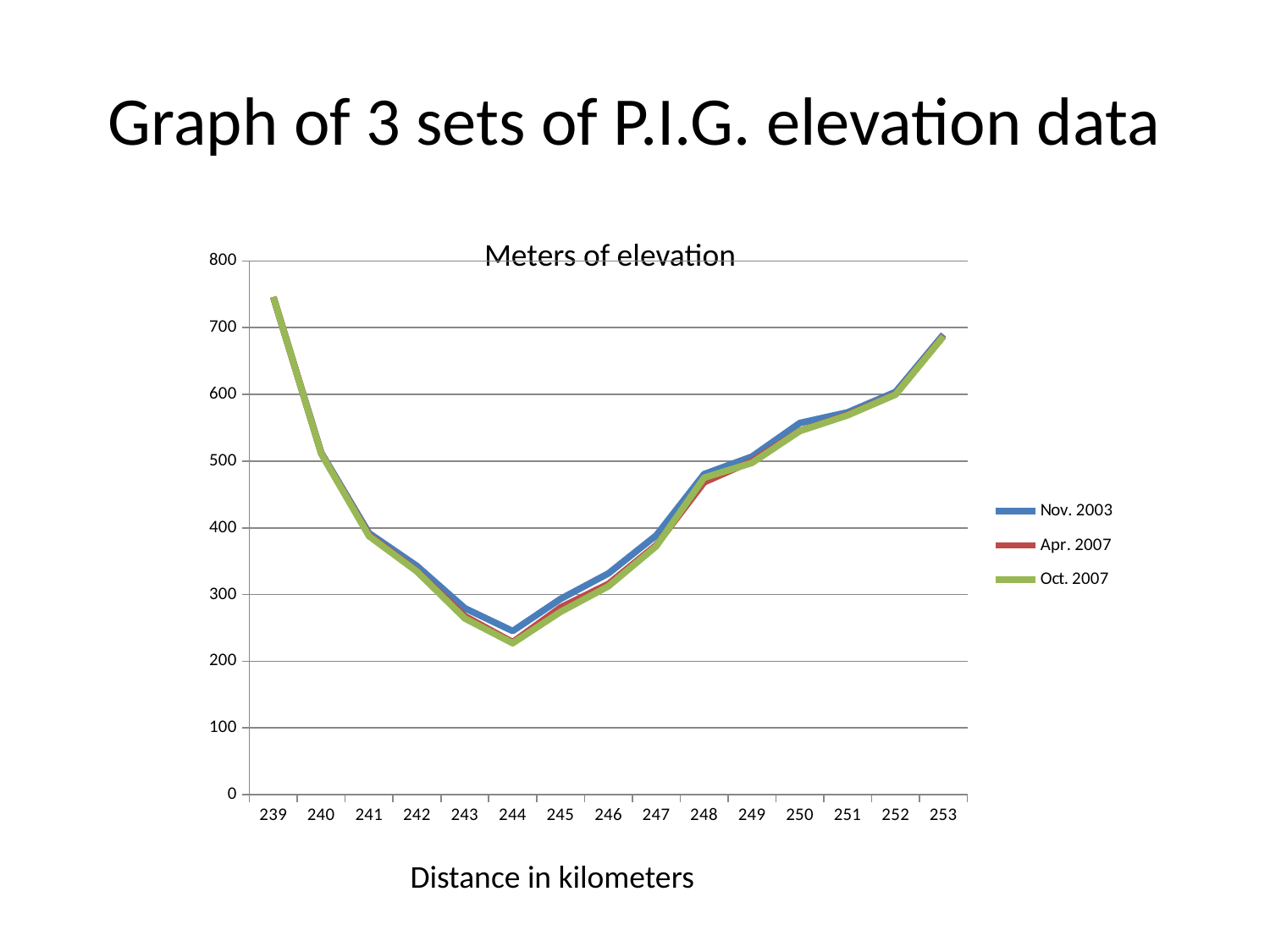
Is the Oct. 2007 value at 244 km greater or less than 300? less Is the Apr. 2007 value at 253 km greater or less than 600? greater What kind of chart is shown on the slide? line chart At which distance is the Oct. 2007 elevation highest? 239 At 244 km, which series has the higher elevation, Nov. 2003 or Oct. 2007? Nov. 2003 At which distance is the Nov. 2003 elevation lowest? 244 Is the Nov. 2003 value at 239 km greater or less than 700? greater Which series are listed in the legend? Nov. 2003, Apr. 2007, Oct. 2007 How many series does the legend list? 3 From 244 km to 253 km, do the elevation values rise or fall? rise What is the title of the chart? Meters of elevation How many distance points are plotted along the x axis? 15